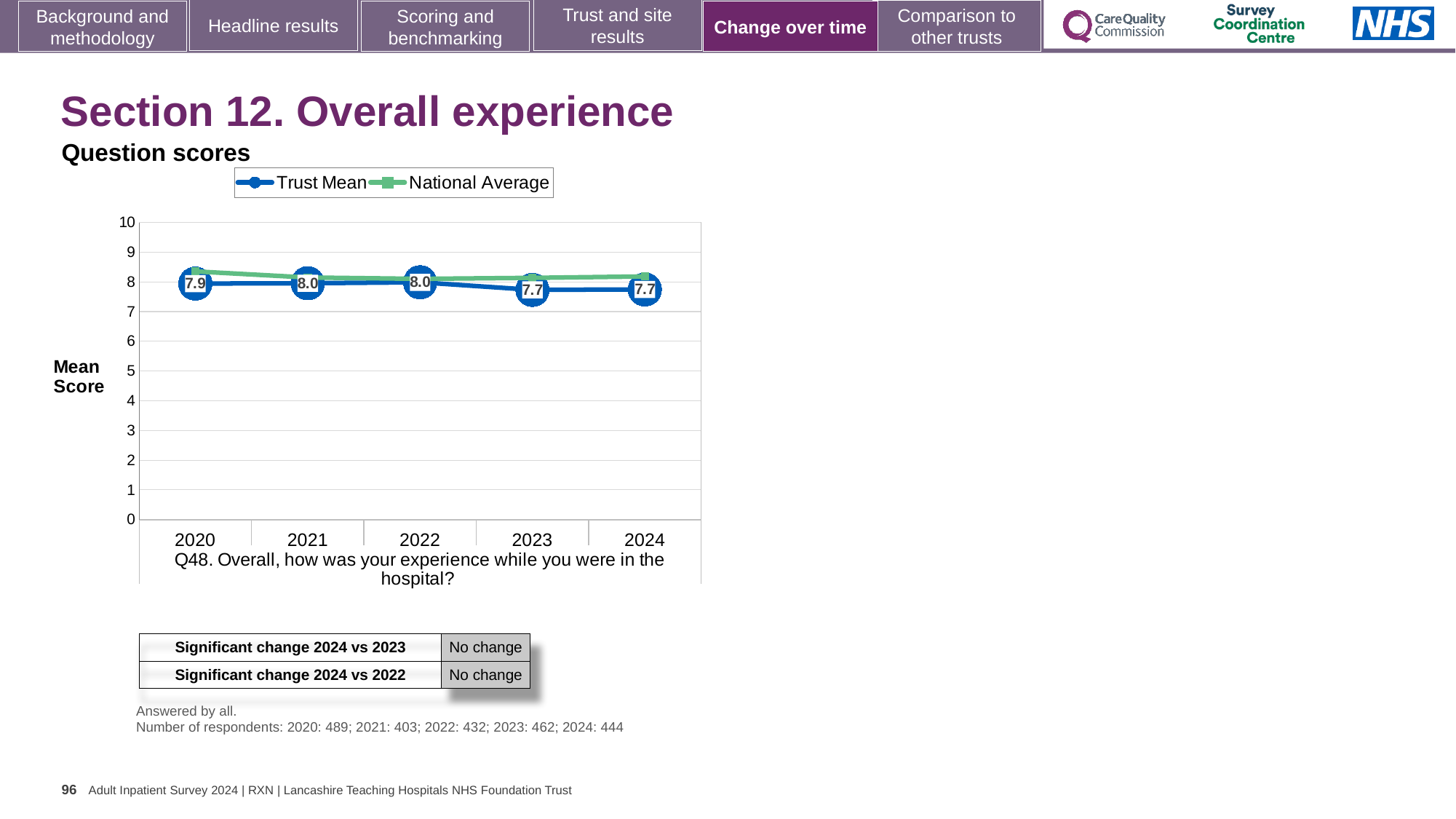
How many series does the legend list? 2 Is the National Average value for 2020 greater or less than 8? greater What is the difference between the Trust Mean score in 2020 and in 2024? 0.2 What is the Trust Mean score for 2022? 8.0 How many years are plotted on the x axis? 5 What kind of chart is shown on the slide? Line chart Does the Trust Mean score rise or fall from 2020 to 2024? Fall What is the Trust Mean score for 2024? 7.7 What are the two series named in the chart legend? Trust Mean and National Average What is the Trust Mean score for 2020? 7.9 Which year has the larger Trust Mean score, 2021 or 2023? 2021 What is the Trust Mean score for 2023? 7.7